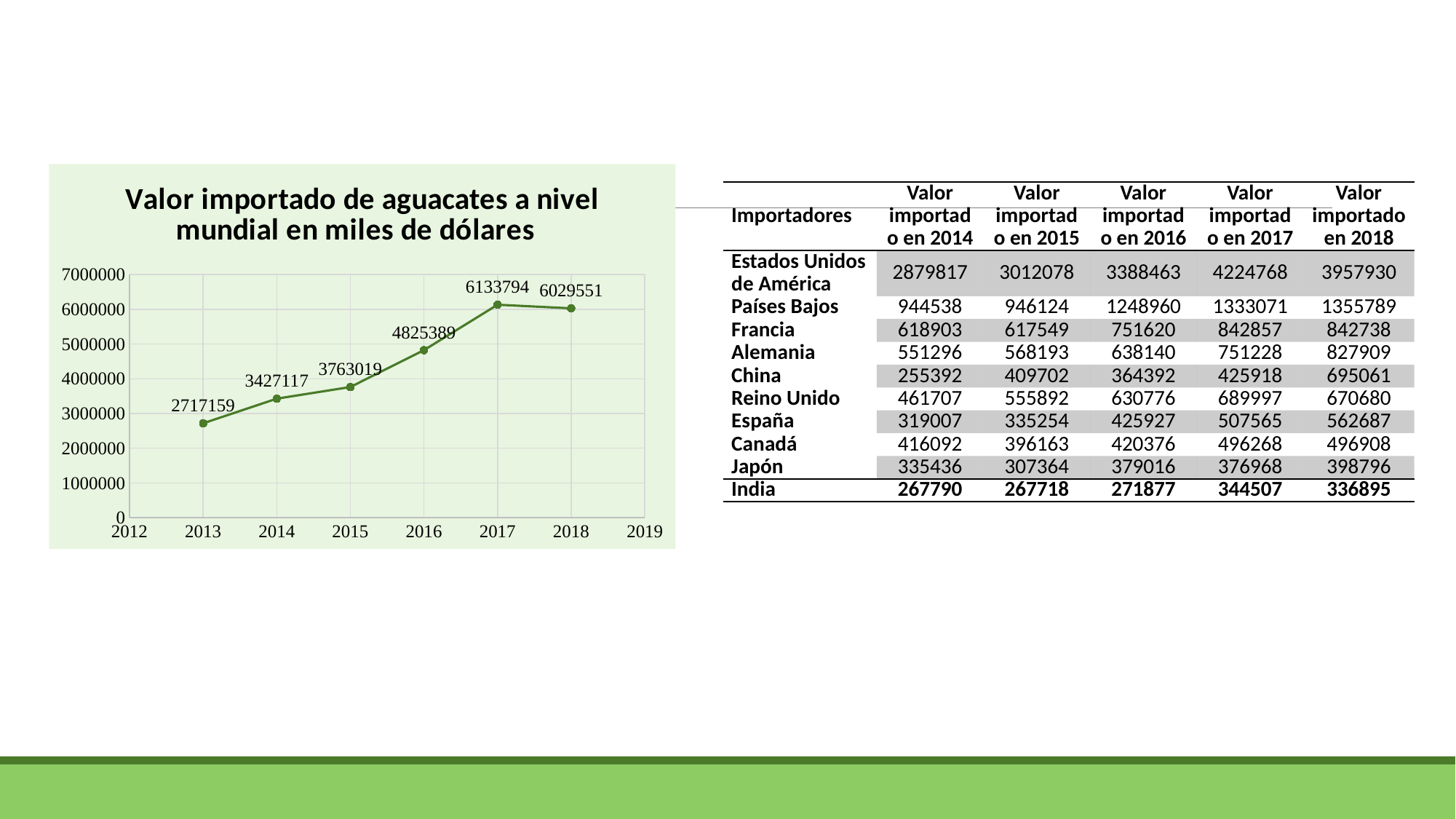
How many data points are plotted on the line? 6 Which is larger, the value for 2017 or the value for 2018? 2017 Does the value rise or fall from 2013 to 2017? Rise What is the title of the chart? Valor importado de aguacates a nivel mundial en miles de dólares What is the difference between the values for 2014 and 2013? 709958 What type of chart is shown on the slide? Line chart Which year has the lowest value in the chart? 2013 What is the value plotted for 2018? 6029551 What is the value plotted for 2016? 4825389 What is the value plotted for 2013? 2717159 Which year has the highest value in the chart? 2017 What is the difference between the values for 2017 and 2016? 1308405